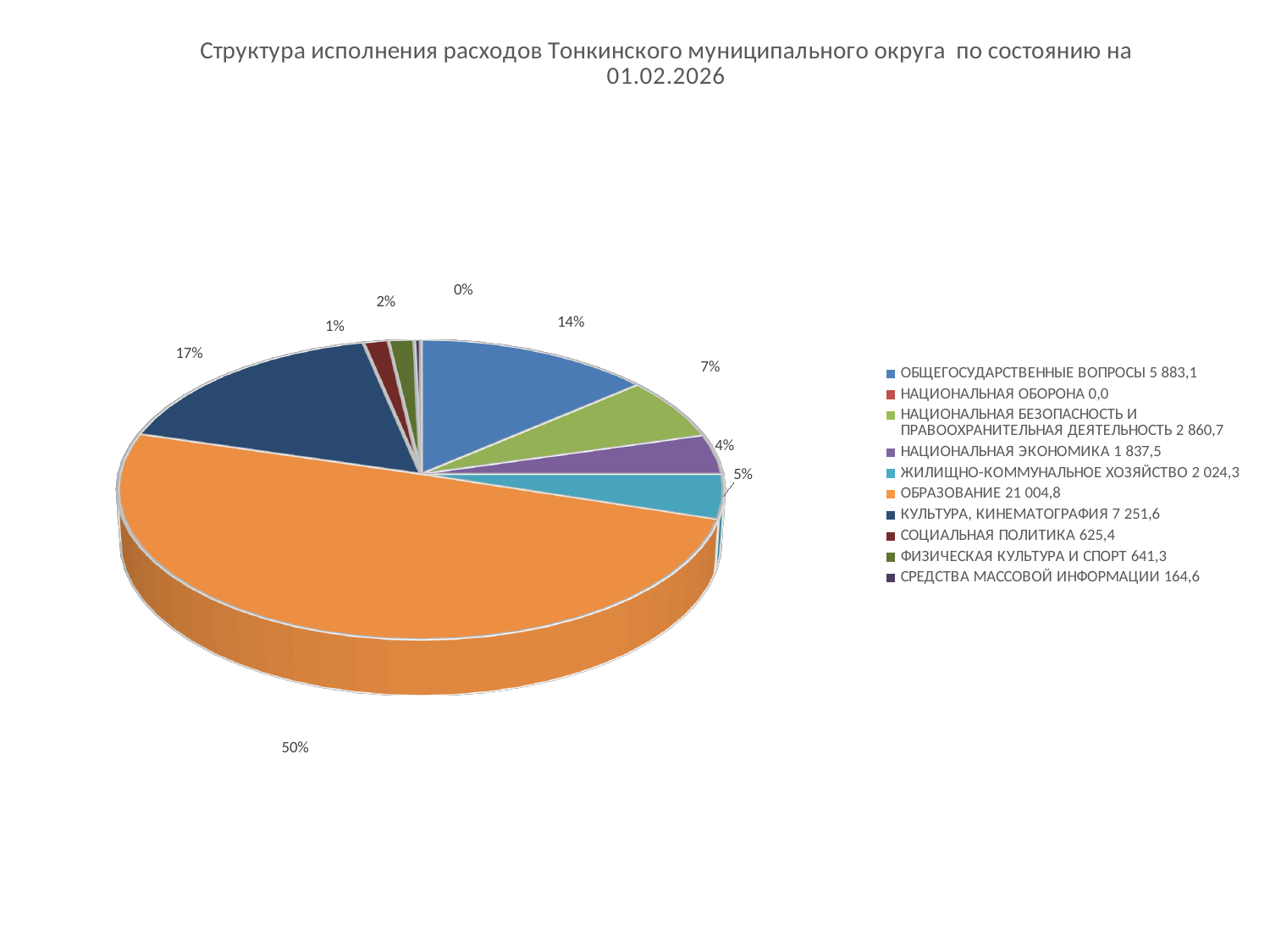
What share of the pie does КУЛЬТУРА, КИНЕМАТОГРАФИЯ account for? 17% How many categories does the legend list? 10 Which category has the smallest value according to the legend? НАЦИОНАЛЬНАЯ ОБОРОНА Which category has the largest slice of the pie? ОБРАЗОВАНИЕ Which is larger, the share for КУЛЬТУРА, КИНЕМАТОГРАФИЯ or the share for ОБЩЕГОСУДАРСТВЕННЫЕ ВОПРОСЫ? КУЛЬТУРА, КИНЕМАТОГРАФИЯ What share of the pie does ОБРАЗОВАНИЕ account for? 50% What value is shown in the legend for ЖИЛИЩНО-КОММУНАЛЬНОЕ ХОЗЯЙСТВО? 2 024,3 What date is given in the chart title? 01.02.2026 What kind of chart is shown on the slide? Pie chart What share of the pie does ОБЩЕГОСУДАРСТВЕННЫЕ ВОПРОСЫ account for? 14% What value is shown in the legend for ОБРАЗОВАНИЕ? 21 004,8 By how many percentage points does the share for КУЛЬТУРА, КИНЕМАТОГРАФИЯ exceed the share for ОБЩЕГОСУДАРСТВЕННЫЕ ВОПРОСЫ? 3 percentage points